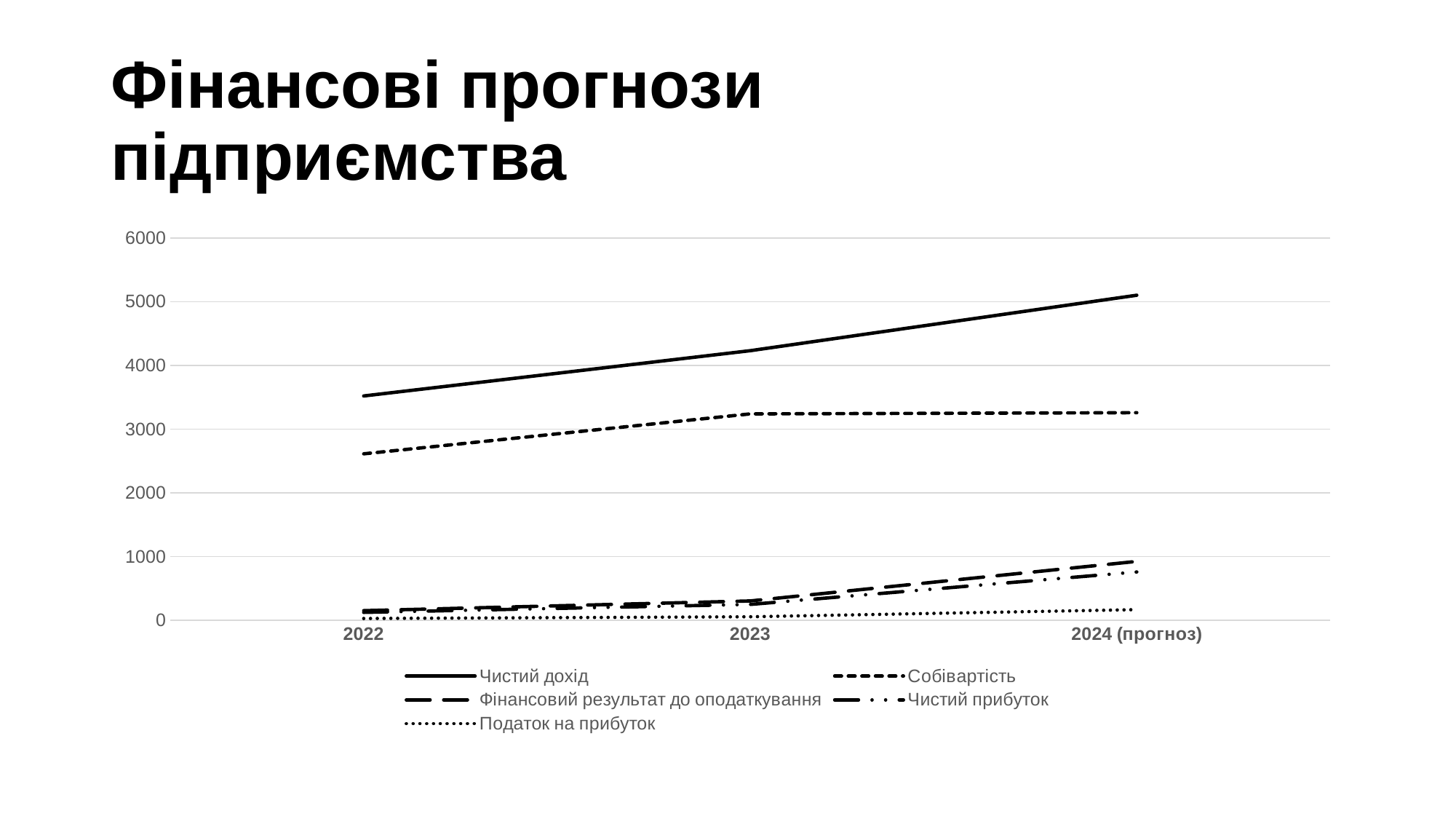
How many series does the legend list? 5 How many points are plotted along the x axis for each series? 3 What is the label of the last category on the x axis? 2024 (прогноз) Which is larger in 2024 (прогноз): Чистий дохід or Собівартість? Чистий дохід Is the value of Чистий дохід in 2022 greater or less than 4000? less Which series has the highest value in 2024 (прогноз)? Чистий дохід Does Чистий дохід rise or fall from 2022 to 2024 (прогноз)? rise What kind of chart is shown on the slide? line chart Is the value of Чистий дохід in 2024 (прогноз) greater or less than 5000? greater Is the value of Собівартість in 2022 greater or less than 3000? less Which series has the lowest value in 2024 (прогноз)? Податок на прибуток